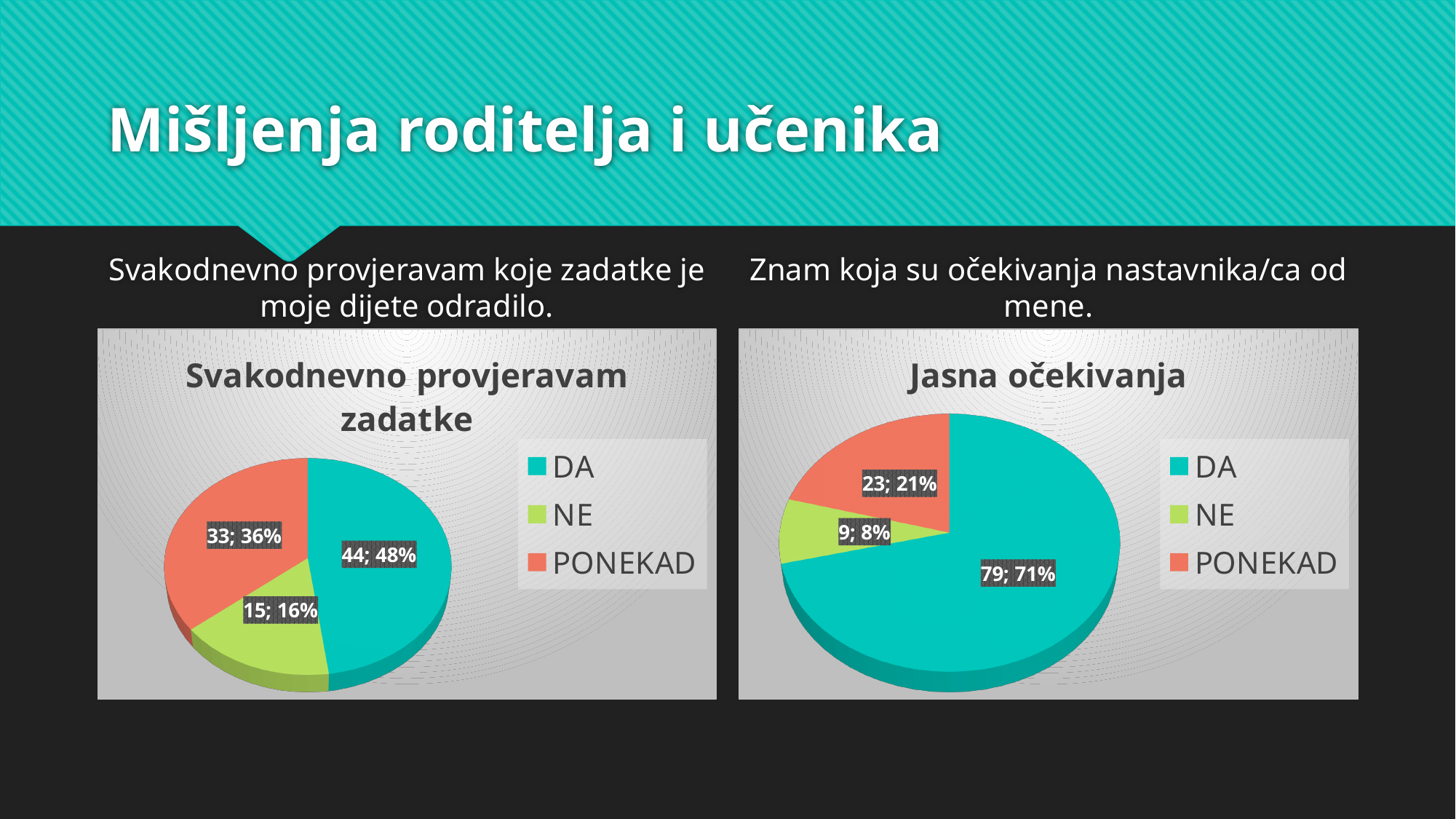
In the 'Svakodnevno provjeravam zadatke' chart, what is the value for NE? 15; 16% What type of chart is the 'Jasna očekivanja' chart? Pie chart In the 'Svakodnevno provjeravam zadatke' chart, what is the difference in count between DA and NE? 29 In the 'Jasna očekivanja' chart, what is the value for PONEKAD? 23; 21% In the 'Jasna očekivanja' chart, what share of the pie does NE represent? 8% In the 'Svakodnevno provjeravam zadatke' chart, which category has the largest slice? DA In the 'Svakodnevno provjeravam zadatke' chart, what is the value for DA? 44; 48% In the 'Svakodnevno provjeravam zadatke' chart, what is the value for PONEKAD? 33; 36% How many categories does the legend of the 'Svakodnevno provjeravam zadatke' chart list? 3 In the 'Jasna očekivanja' chart, which category has the smallest slice? NE In the 'Jasna očekivanja' chart, which is larger, PONEKAD or NE? PONEKAD In the 'Jasna očekivanja' chart, what is the value for DA? 79; 71%